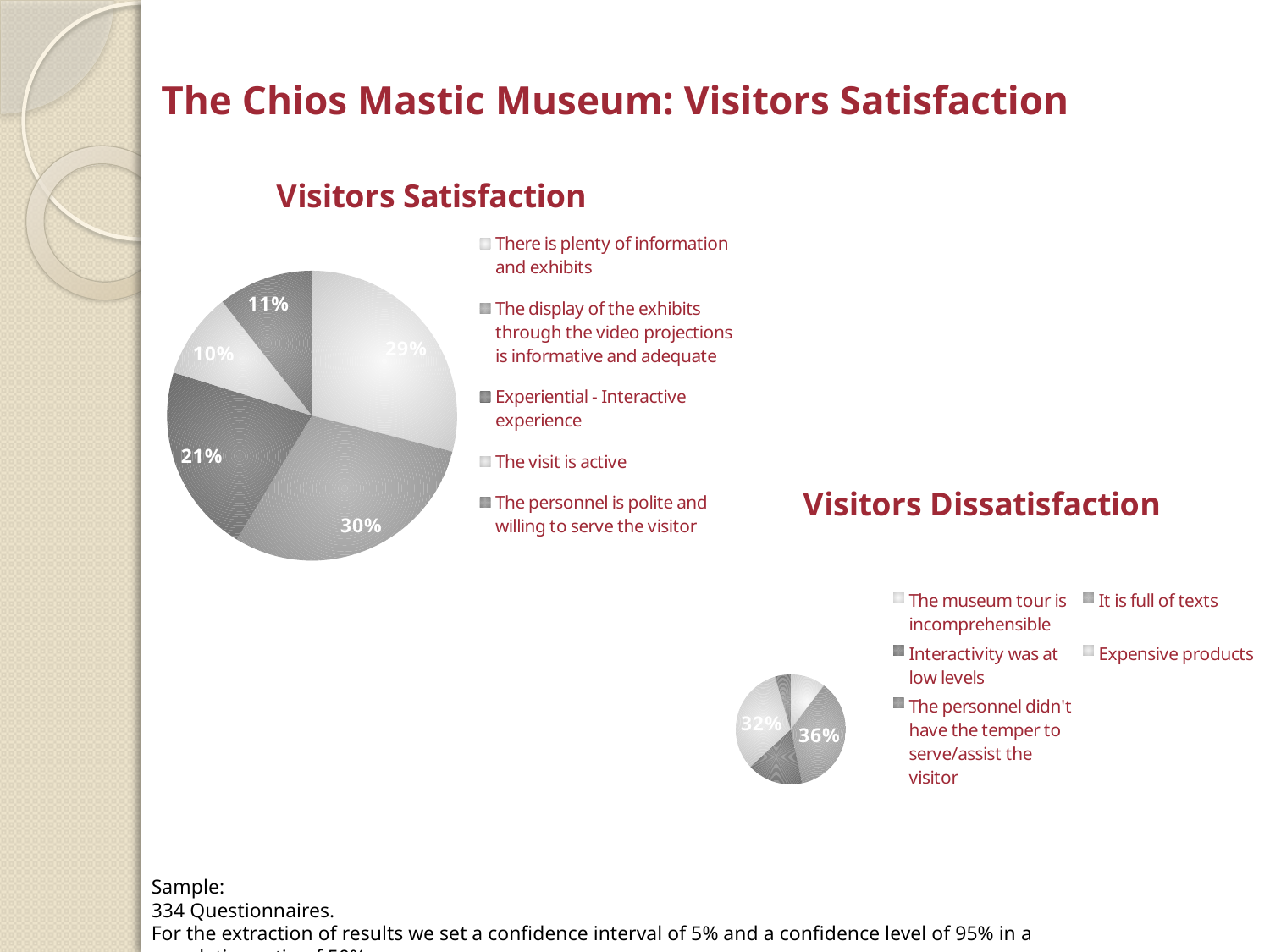
How many categories does the legend of the Visitors Dissatisfaction chart list? 5 What kind of chart is the Visitors Dissatisfaction chart? pie chart In the Visitors Satisfaction chart, what share of the pie is labelled for 'Experiential - Interactive experience'? 21% In the Visitors Satisfaction chart, what share of the pie is labelled for 'There is plenty of information and exhibits'? 29% In the Visitors Satisfaction chart, what is the smallest percentage shown on any slice? 10% What kind of chart is the Visitors Satisfaction chart? pie chart What is the title of the chart on the left side of the slide? Visitors Satisfaction In the Visitors Dissatisfaction chart, what is the largest percentage labelled on a slice? 36% In the Visitors Dissatisfaction chart, what is the difference between the two labelled slices, 36% and 32%? 4% In the Visitors Satisfaction chart, what is the difference between the largest slice (30%) and the smallest slice (10%)? 20% In the Visitors Satisfaction chart, what is the largest percentage shown on any slice? 30% How many categories does the legend of the Visitors Satisfaction chart list? 5